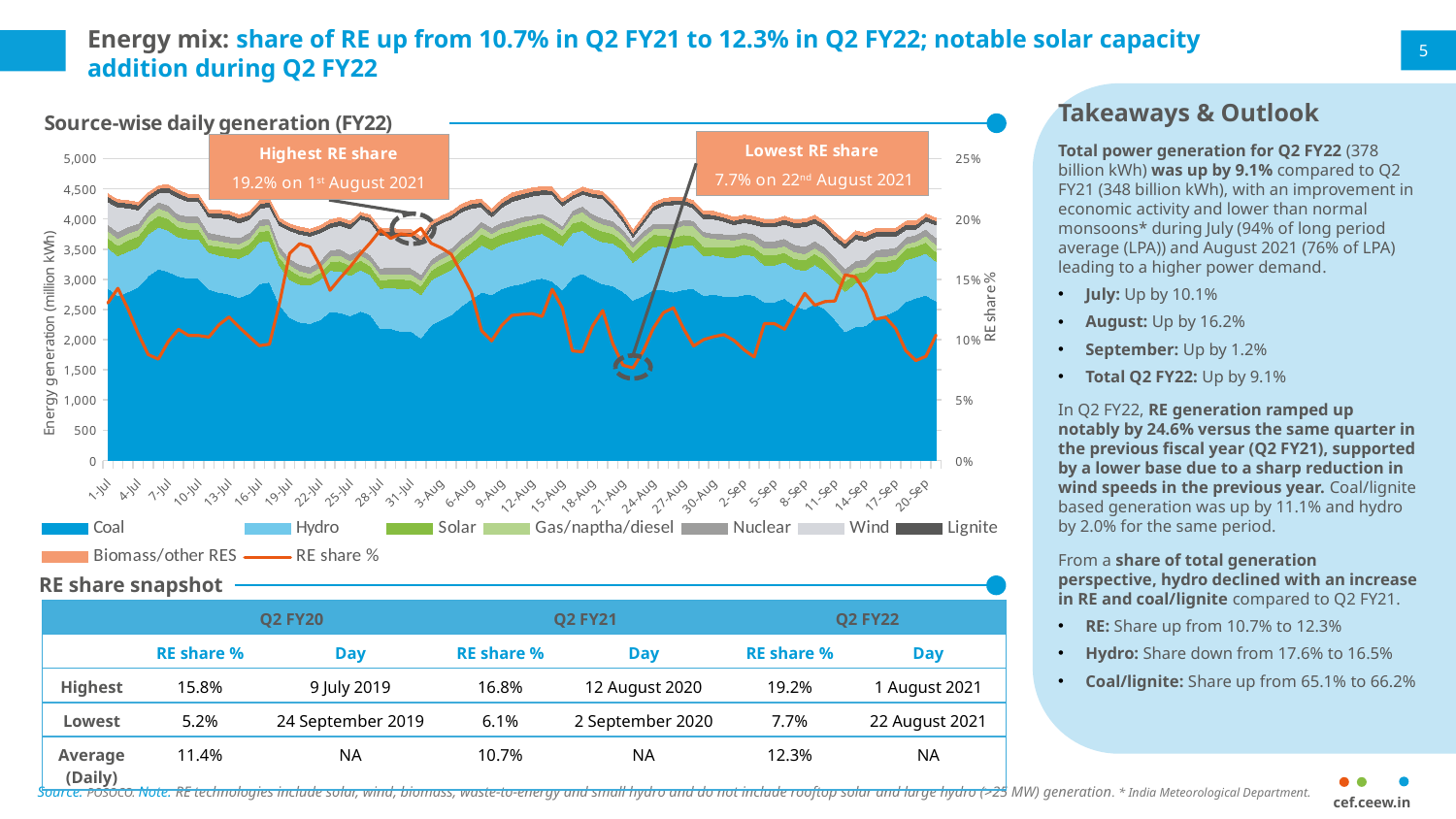
What is the maximum value shown on the left-hand axis (Energy generation, million kWh)? 5,000 What is the difference in percentage points between the highest RE share (19.2%) and the lowest RE share (7.7%) annotated on the chart? 11.5 percentage points On which date did the lowest RE share of 7.7% occur, according to the chart annotation? 22nd August 2021 On which date did the highest RE share of 19.2% occur, according to the chart annotation? 1st August 2021 What kind of chart is used to show source-wise daily generation? Stacked area chart with a line for RE share % Is the coal generation on 1-Jul greater or less than 2,000 million kWh? greater What is the title of the chart on the slide? Source-wise daily generation (FY22) According to the chart annotation, what was the highest RE share in the period shown? 19.2% How many series does the chart legend list? 9 Which series is plotted as a line rather than a stacked area in the chart? RE share % Which is larger: the RE share on 1st August 2021 or the RE share on 22nd August 2021? 1st August 2021 According to the chart annotation, what was the lowest RE share in the period shown? 7.7%